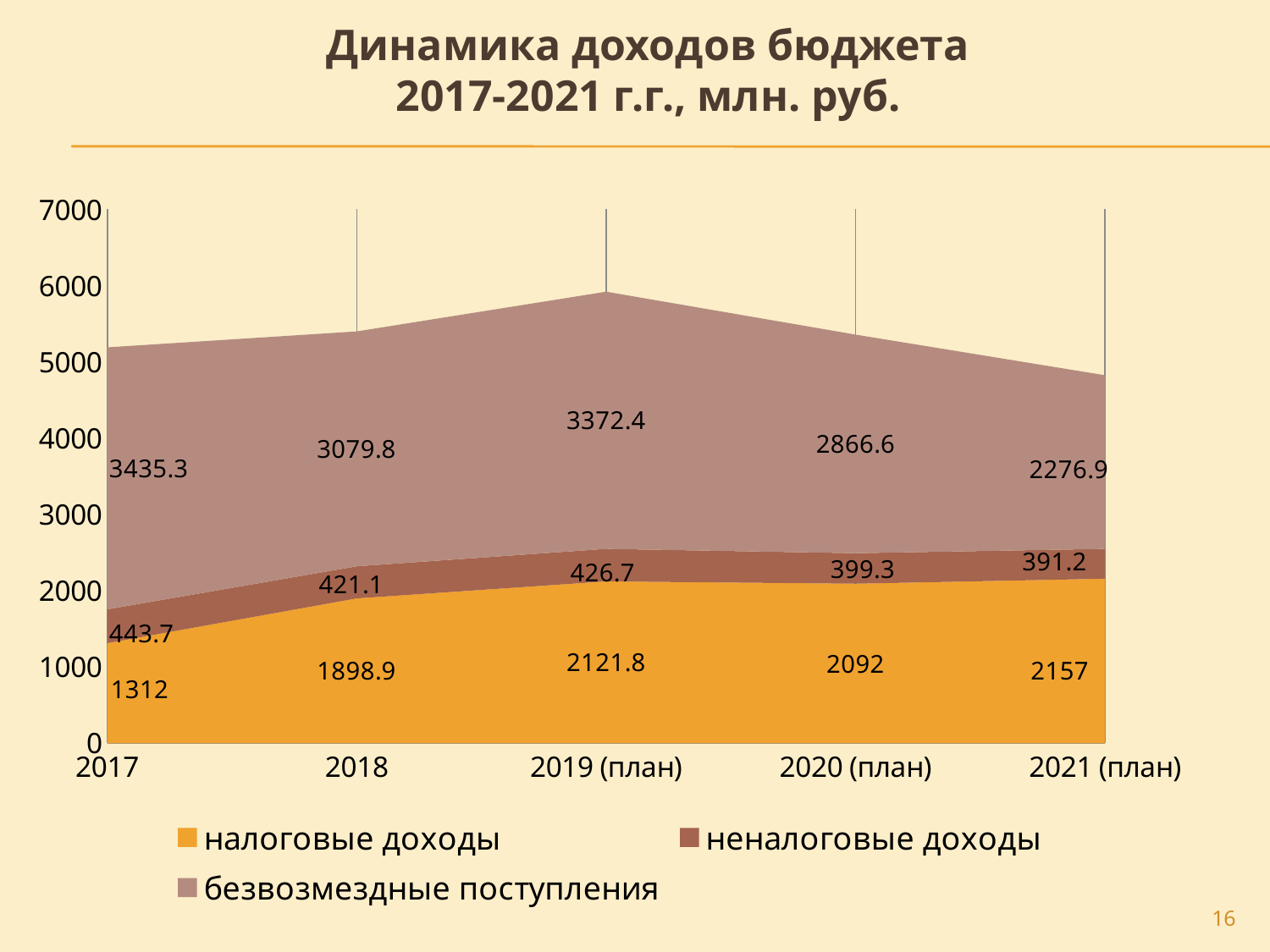
What is the value of неналоговые доходы in 2021 (план)? 391.2 What is the total of all three series in 2019 (план)? 5920.9 In which year is налоговые доходы the highest? 2021 (план) What is the difference between безвозмездные поступления in 2017 and in 2021 (план)? 1158.4 What is the value of безвозмездные поступления in 2019 (план)? 3372.4 In which year is безвозмездные поступления the lowest? 2021 (план) Does неналоговые доходы rise or fall from 2019 (план) to 2021 (план)? Fall How many series does the legend list? 3 Which is larger: налоговые доходы in 2019 (план) or in 2020 (план)? 2019 (план) What kind of chart is shown on the slide? Stacked area chart What is the value of налоговые доходы in 2017? 1312 How many years are shown on the x axis? 5